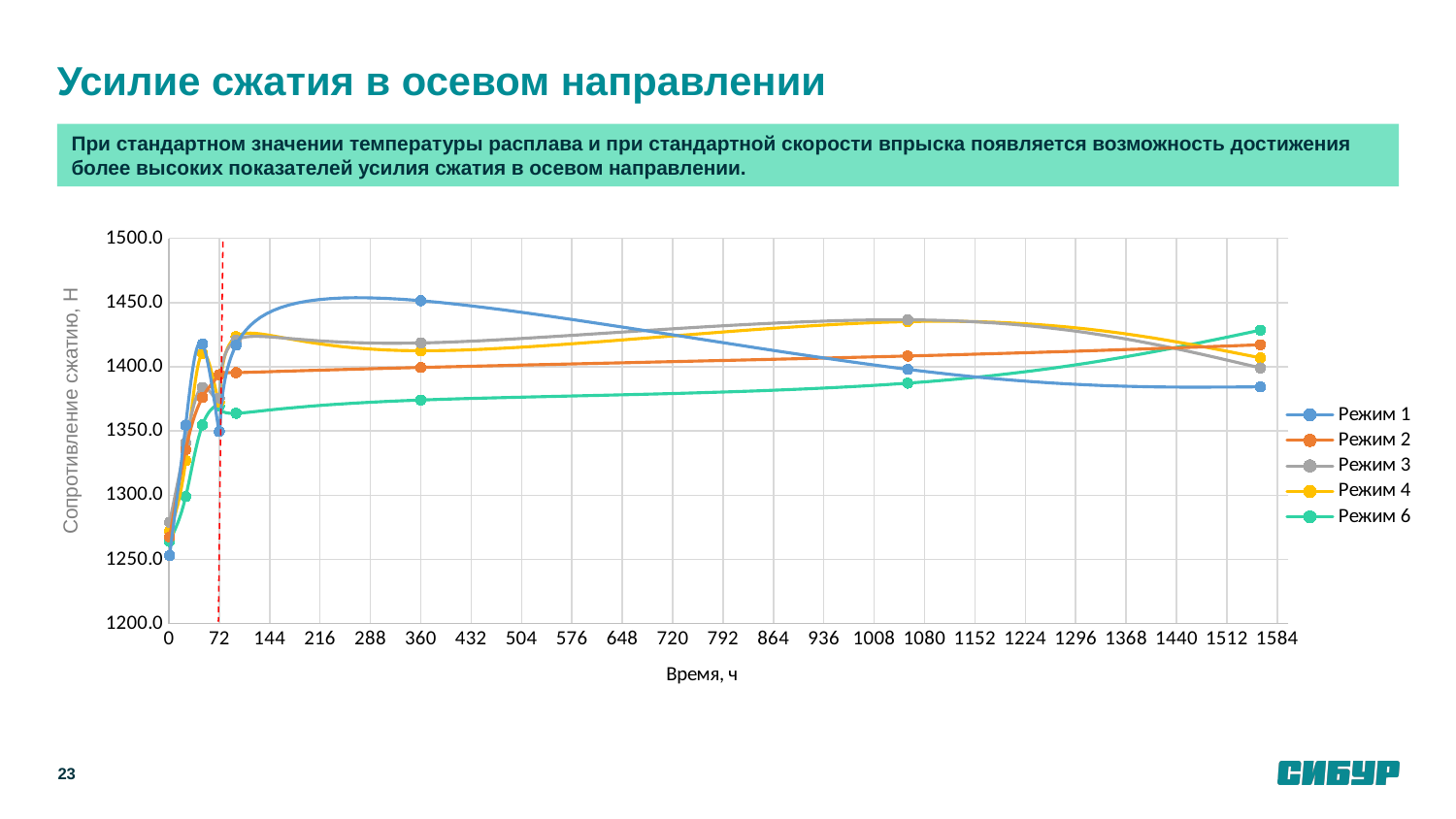
What are the series names listed in the legend? Режим 1, Режим 2, Режим 3, Режим 4, Режим 6 How many series does the legend list? 5 What is the title of the vertical axis? Сопротивление сжатию, Н Is the value for Режим 1 at 360 hours greater or less than 1400? greater Is the value for Режим 1 at 0 hours greater or less than 1300? less Is the value for Режим 3 at about 1080 hours greater or less than 1400? greater What kind of chart is shown on the slide? line chart Does the value for Режим 1 rise or fall from 360 hours to the end of the x axis? fall At the last time point (around 1560 hours), which is larger: Режим 6 or Режим 1? Режим 6 Which series has the lowest value at about 1080 hours? Режим 6 Which series has the highest value at 360 hours? Режим 1